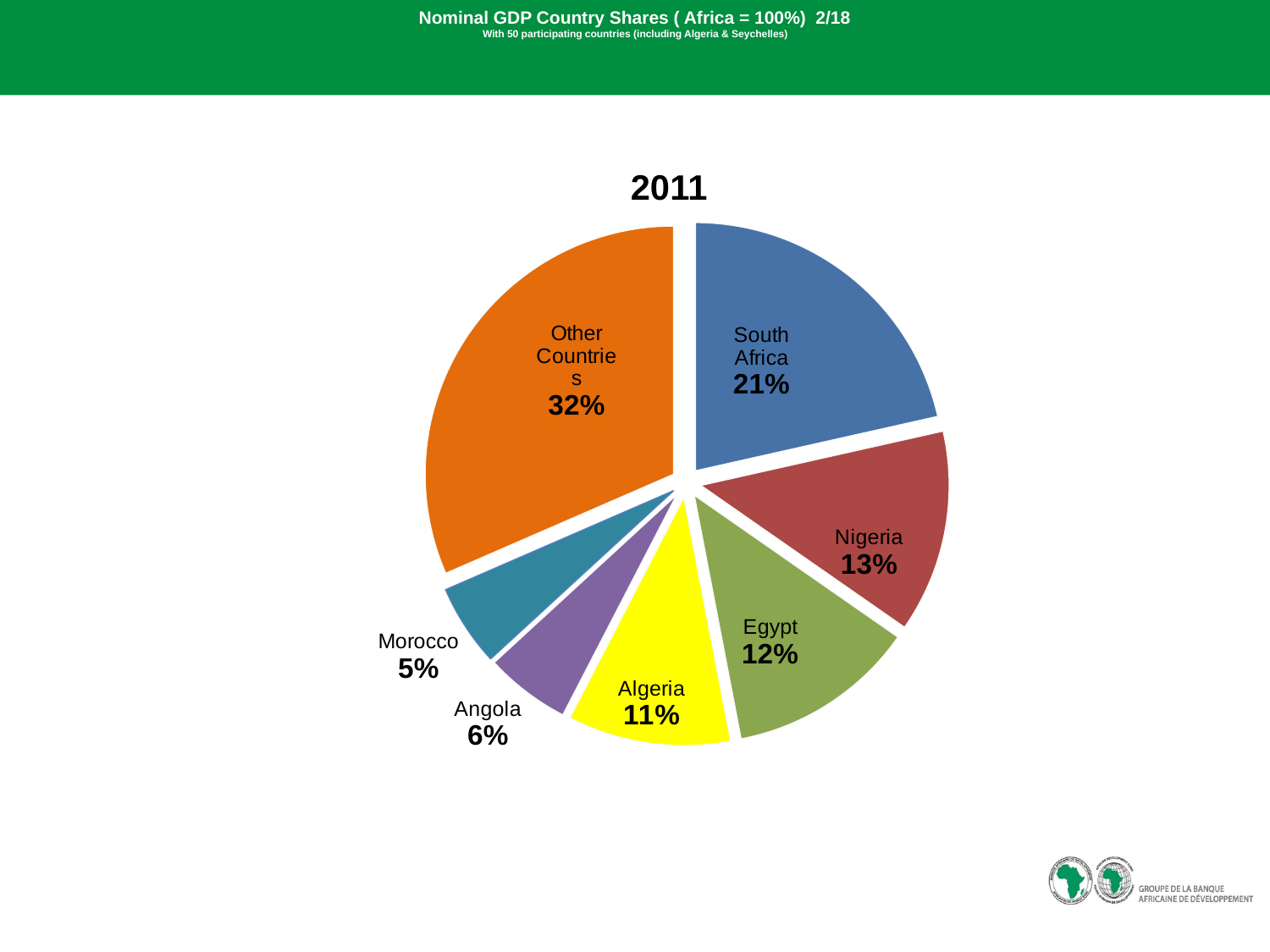
What share does Morocco hold in the pie chart? 5% How many slices does the pie chart have? 7 What share does Nigeria hold in the pie chart? 13% What share does Algeria hold in the pie chart? 11% Which slice of the pie chart is the largest? Other Countries What share of nominal GDP does South Africa hold in the pie chart? 21% What is the chart's title? 2011 Which slice of the pie chart is the smallest? Morocco What type of chart is shown on the slide? pie chart Which has a larger share, Angola or Morocco? Angola What is the difference in share between South Africa and Nigeria? 8% What share does Egypt hold in the pie chart? 12%